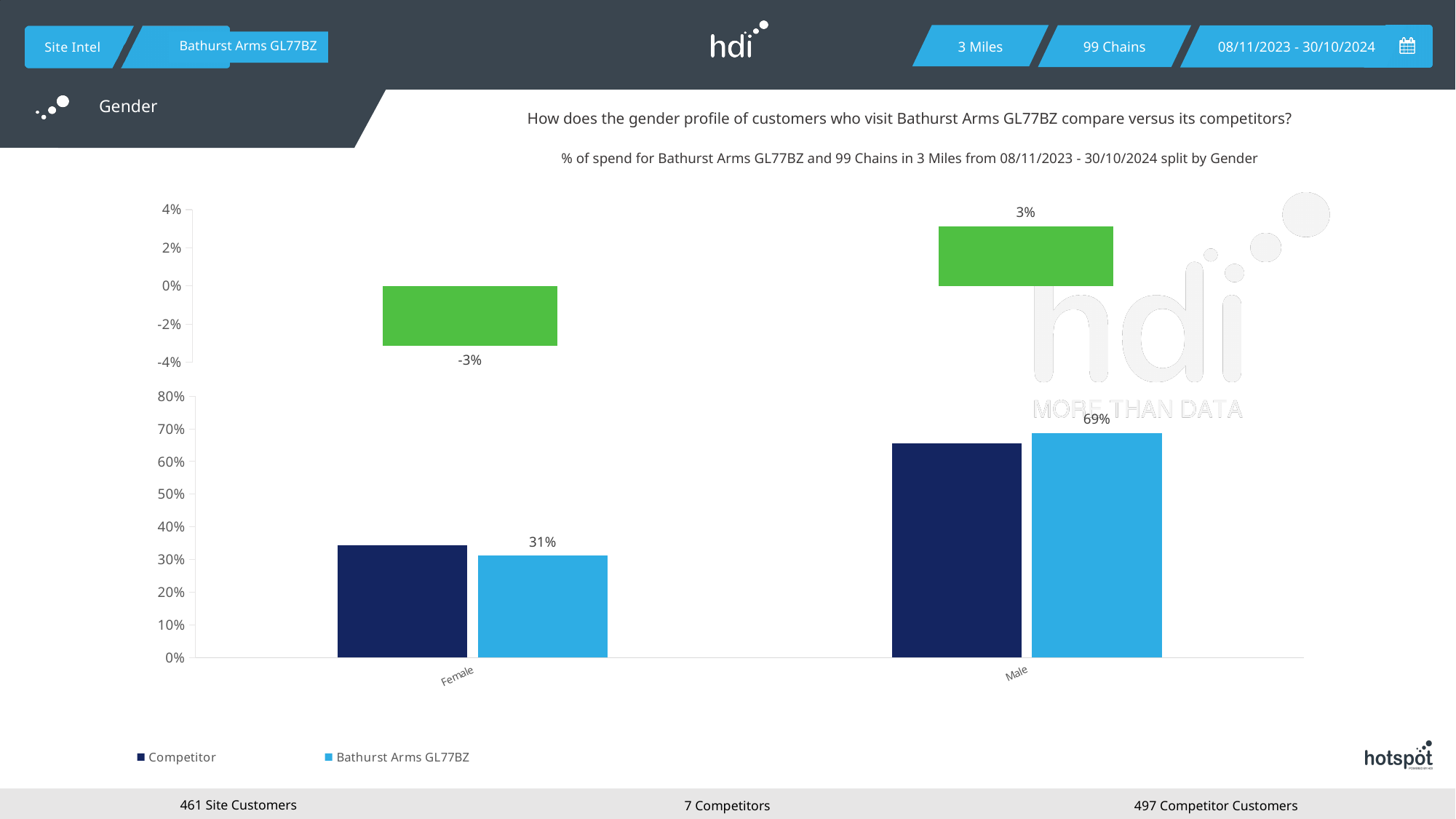
In the lower bar chart, which gender category has the higher value for Bathurst Arms GL77BZ? Male In the lower bar chart, what is the difference between the Bathurst Arms GL77BZ values for Male and Female? 38% In the upper green difference chart, what is the value shown for Female? -3% In the lower bar chart, what is the value for Bathurst Arms GL77BZ for Female? 31% In the lower bar chart, is the Competitor value for Male greater or less than 60%? greater In the lower bar chart, for Female, which is larger: the Competitor bar or the Bathurst Arms GL77BZ bar? Competitor What type of chart is the lower chart on the slide? Bar chart How many series does the legend of the lower bar chart list? 2 In the lower bar chart, what is the value for Bathurst Arms GL77BZ for Male? 69% In the lower bar chart, is the Competitor value for Female greater or less than 30%? greater In the lower bar chart, for Male, which is larger: the Competitor bar or the Bathurst Arms GL77BZ bar? Bathurst Arms GL77BZ In the upper green difference chart, what is the value shown for Male? 3%